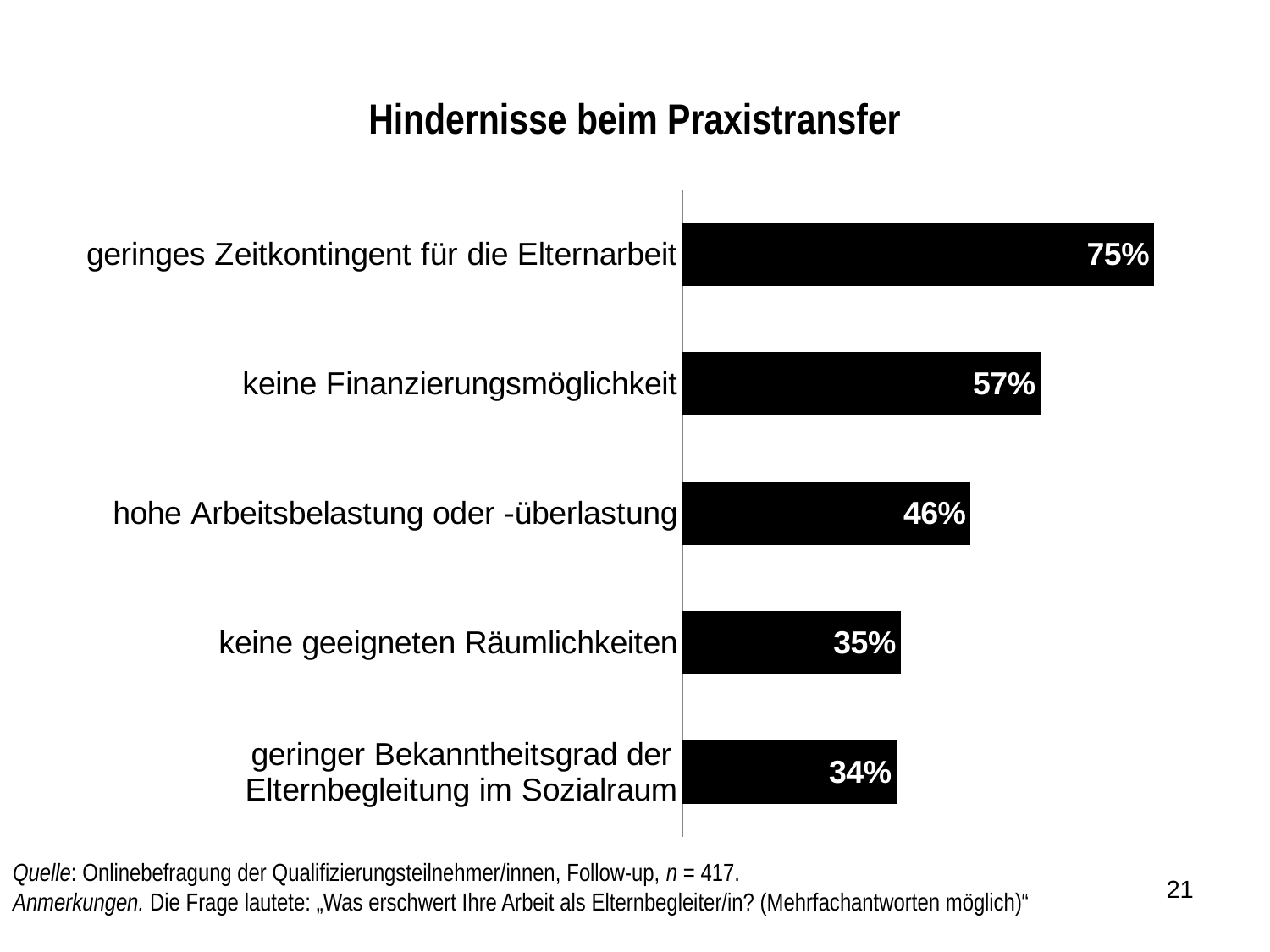
What kind of chart is shown on the slide? bar chart Which category has the lowest value? geringer Bekanntheitsgrad der Elternbegleitung im Sozialraum Which is larger, the value for "keine Finanzierungsmöglichkeit" or the value for "hohe Arbeitsbelastung oder -überlastung"? keine Finanzierungsmöglichkeit Which category has the highest value? geringes Zeitkontingent für die Elternarbeit What is the title of the chart? Hindernisse beim Praxistransfer What is the value for "geringer Bekanntheitsgrad der Elternbegleitung im Sozialraum"? 34% How many categories are shown in the chart? 5 What is the value for "keine Finanzierungsmöglichkeit"? 57% What is the difference between the values for "geringes Zeitkontingent für die Elternarbeit" and "keine Finanzierungsmöglichkeit"? 18% What is the difference between the values for "hohe Arbeitsbelastung oder -überlastung" and "keine geeigneten Räumlichkeiten"? 11% What is the value for "geringes Zeitkontingent für die Elternarbeit"? 75% What is the value for "hohe Arbeitsbelastung oder -überlastung"? 46%